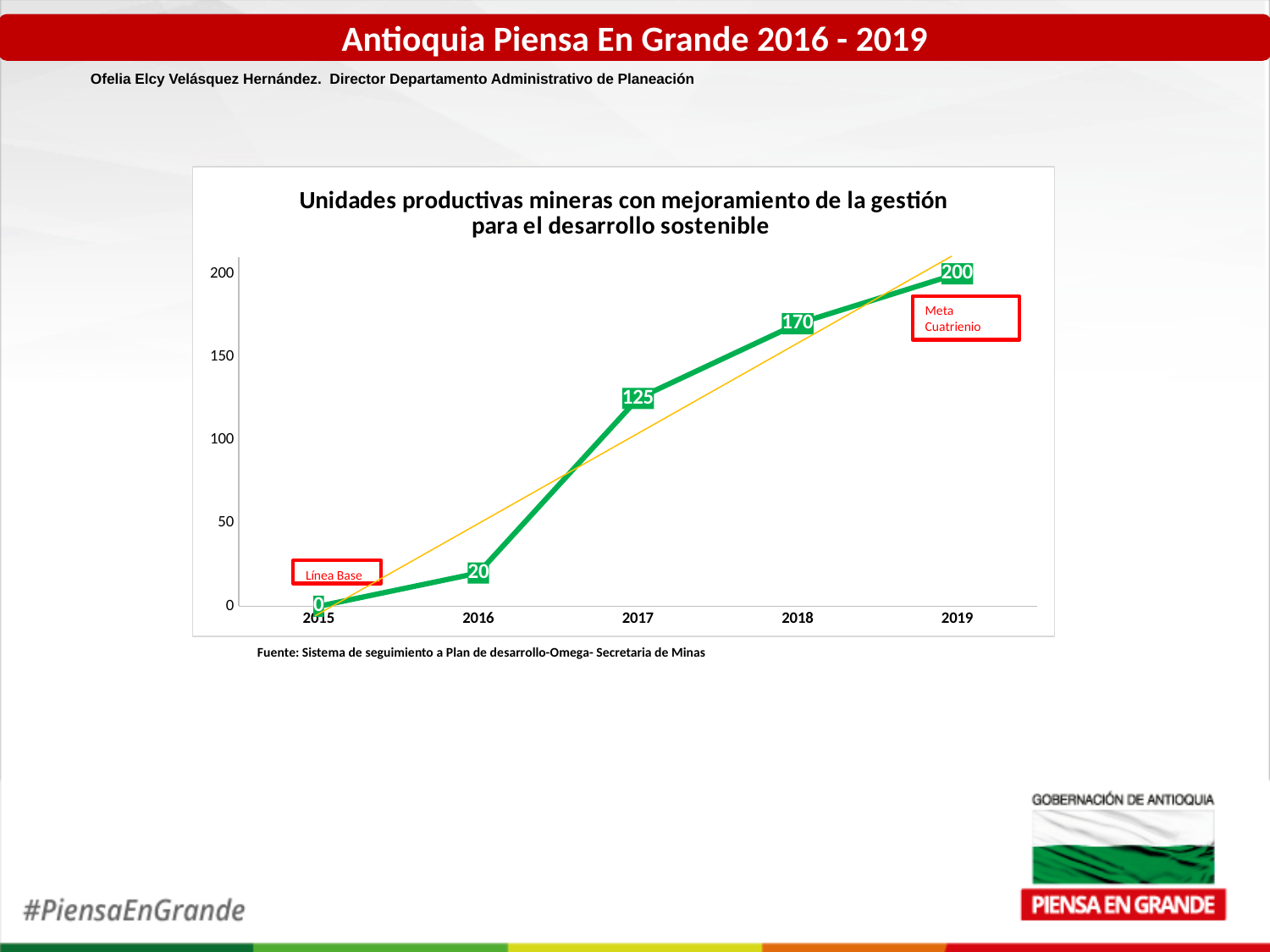
Which year has the highest value in the chart? 2019 How many years are plotted on the x axis of the chart? 5 Which is larger, the value for 2017 or the value for 2018? 2018 What is the value for 2015 in the chart? 0 What is the difference between the values for 2017 and 2016? 105 What is the difference between the values for 2019 and 2018? 30 Do the values rise or fall from 2015 to 2019? rise What kind of chart is shown on the slide? line chart What is the value for 2016 in the chart? 20 What is the value for 2017 in the chart? 125 What is the value for 2018 in the chart? 170 Which year has the lowest value in the chart? 2015